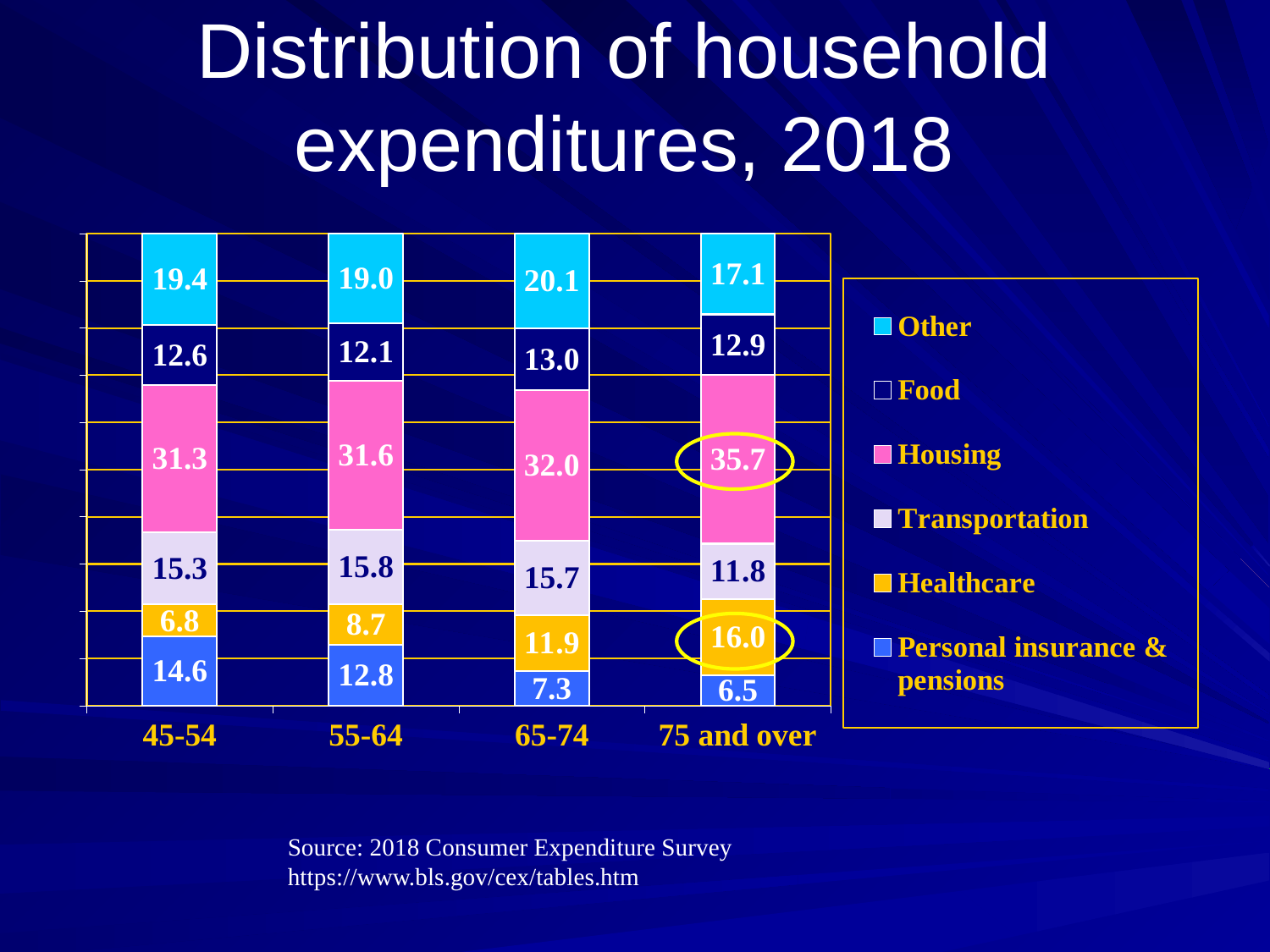
Which age group has the highest Healthcare value? 75 and over What kind of chart is shown on the slide? Stacked bar chart What is the difference between the Healthcare values for the 75 and over and 45-54 age groups? 9.2 What is the Healthcare value for the 45-54 age group? 6.8 How many series does the legend list? 6 Which is larger, the Transportation value for 55-64 or for 75 and over? 55-64 How many age groups are shown on the x axis? 4 What is the total of the stacked bar for the 65-74 age group? 100.0 Do the Healthcare values rise or fall as the age groups increase along the x axis? Rise Which age group has the lowest Personal insurance & pensions value? 75 and over What is the Personal insurance & pensions value for the 65-74 age group? 7.3 What is the Housing value for the 75 and over age group? 35.7